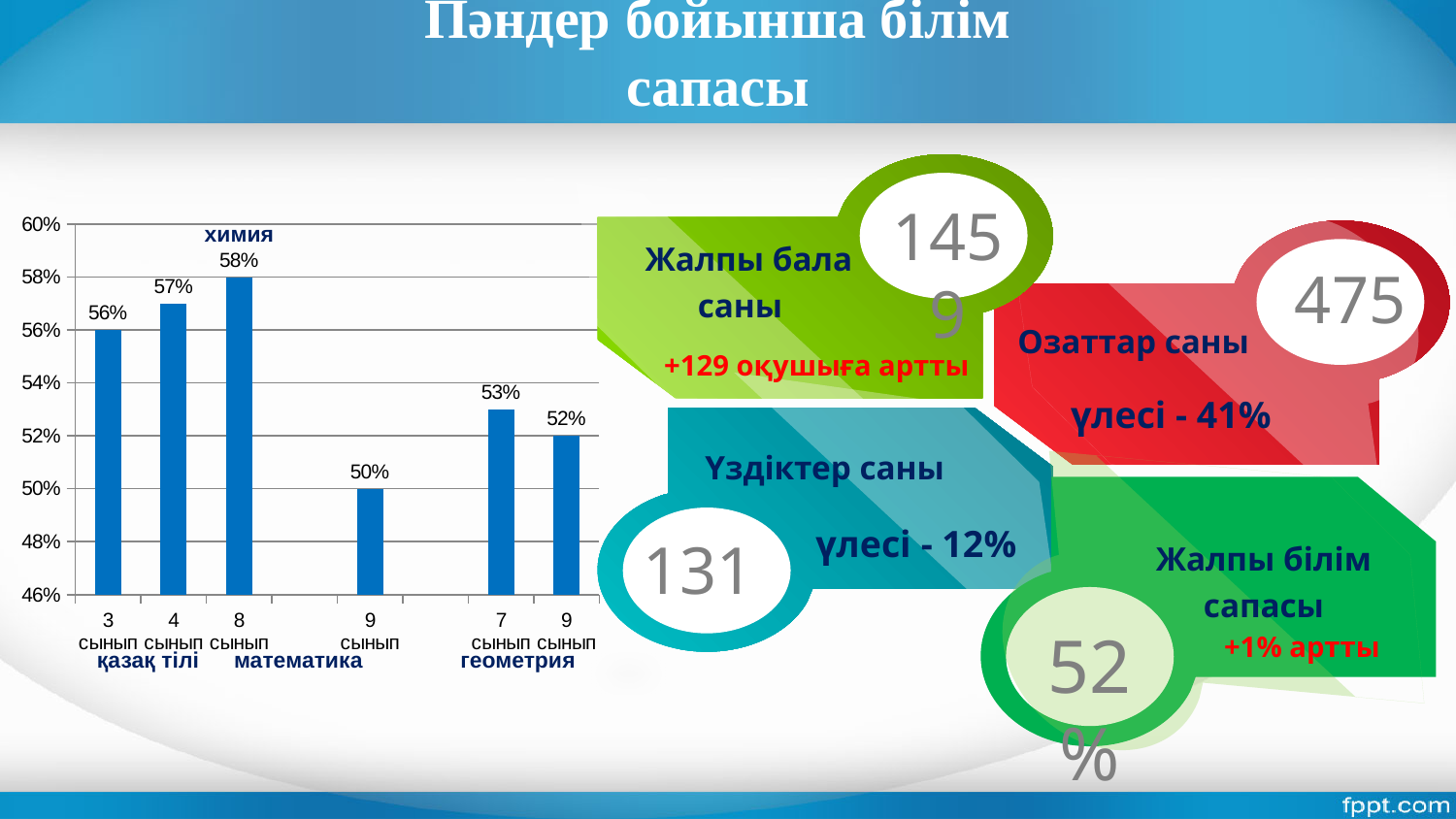
What is the value for 3 сынып (қазақ тілі)? 56% What type of chart is shown on the left of the slide? bar chart Is the value for 9 сынып (математика) greater or less than 52%? less Which bar has the lowest value? 9 сынып (математика) What is the value for 8 сынып (химия)? 58% What is the difference between the value for 8 сынып (химия) and the value for 9 сынып (математика)? 8% Which is larger: the value for 7 сынып (геометрия) or the value for 9 сынып (геометрия)? 7 сынып (геометрия) What is the value for 9 сынып under математика? 50% How many bars are plotted in the chart? 6 What is the value for 7 сынып (геометрия)? 53% What is the value for 4 сынып (қазақ тілі)? 57% Which bar has the highest value? 8 сынып (химия)